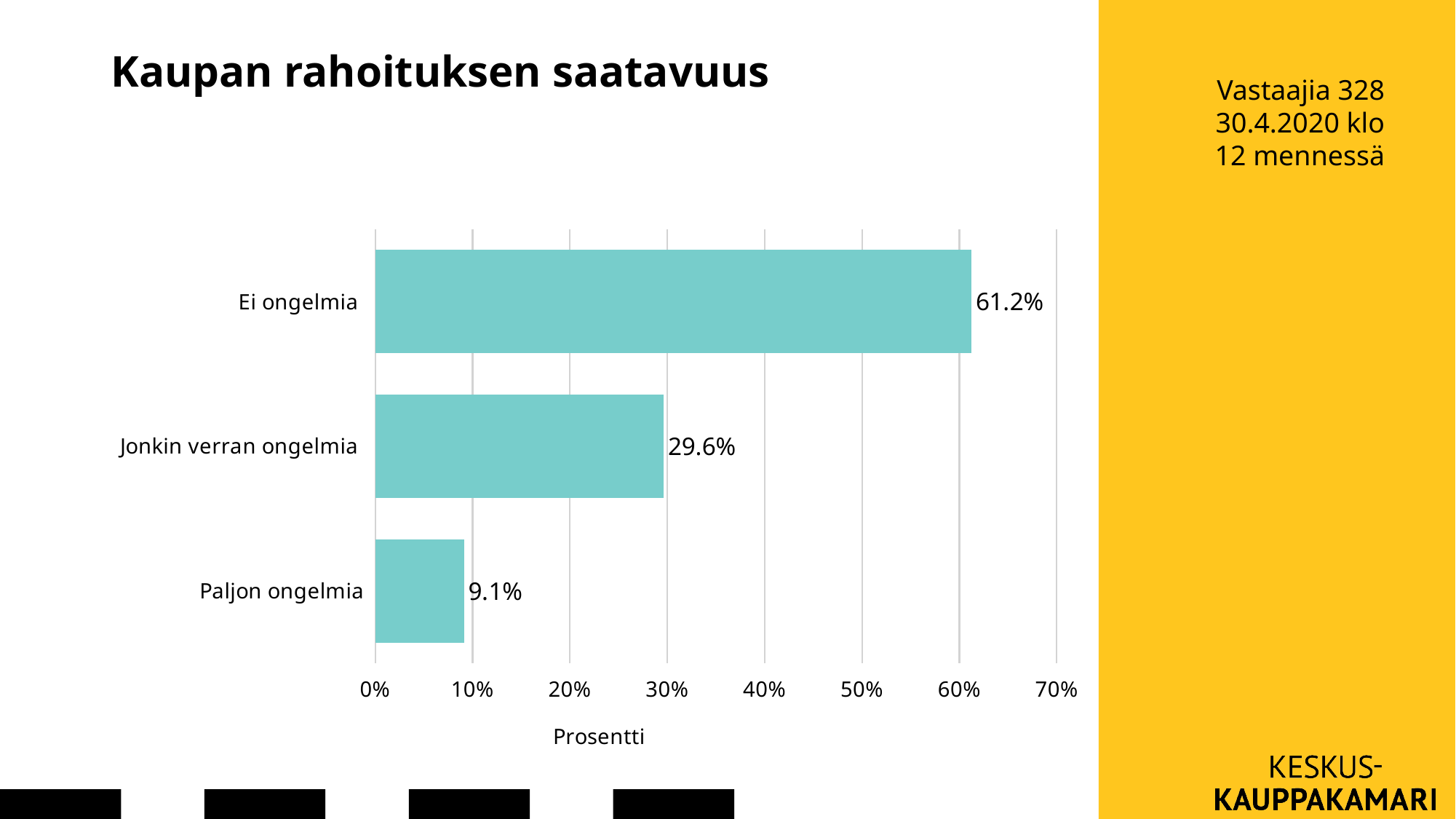
Which is larger, the value for Jonkin verran ongelmia or the value for Paljon ongelmia? Jonkin verran ongelmia What is the value for Jonkin verran ongelmia? 29.6% Which category has the highest value? Ei ongelmia Which category has the lowest value? Paljon ongelmia What is the title of the chart? Kaupan rahoituksen saatavuus What is the value for Paljon ongelmia? 9.1% Is the value for Ei ongelmia greater or less than 50%? greater What is the value for Ei ongelmia? 61.2% What is the difference between the values for Jonkin verran ongelmia and Paljon ongelmia? 20.5% How many categories are shown in the chart? 3 What is the difference between the values for Ei ongelmia and Jonkin verran ongelmia? 31.6% What kind of chart is shown on the slide? Bar chart